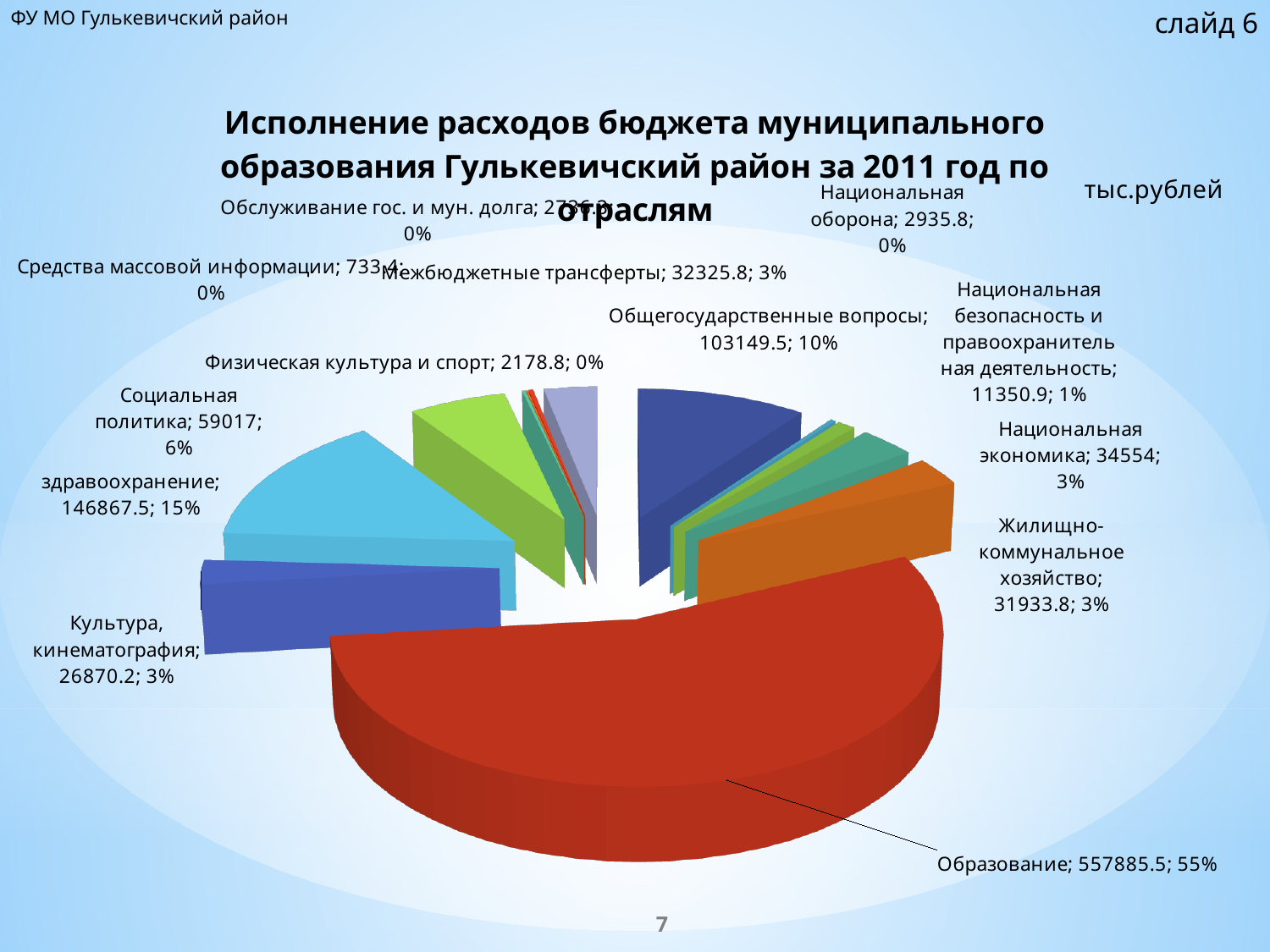
Which category has the smallest value shown on the chart? Средства массовой информации What share of the pie does Образование represent? 55% What kind of chart is shown on the slide? pie chart Which is larger, the value for здравоохранение or the value for Социальная политика? здравоохранение Which category has the largest slice of the pie? Образование What is the difference between the values for Национальная экономика and Жилищно-коммунальное хозяйство? 2620.2 What is the value for Межбюджетные трансферты? 32325.8 What is the value for Образование? 557885.5 What is the value for Общегосударственные вопросы? 103149.5 What is the value for здравоохранение? 146867.5 In what units are the chart values given, according to the slide? тыс.рублей What share of the pie does здравоохранение represent? 15%